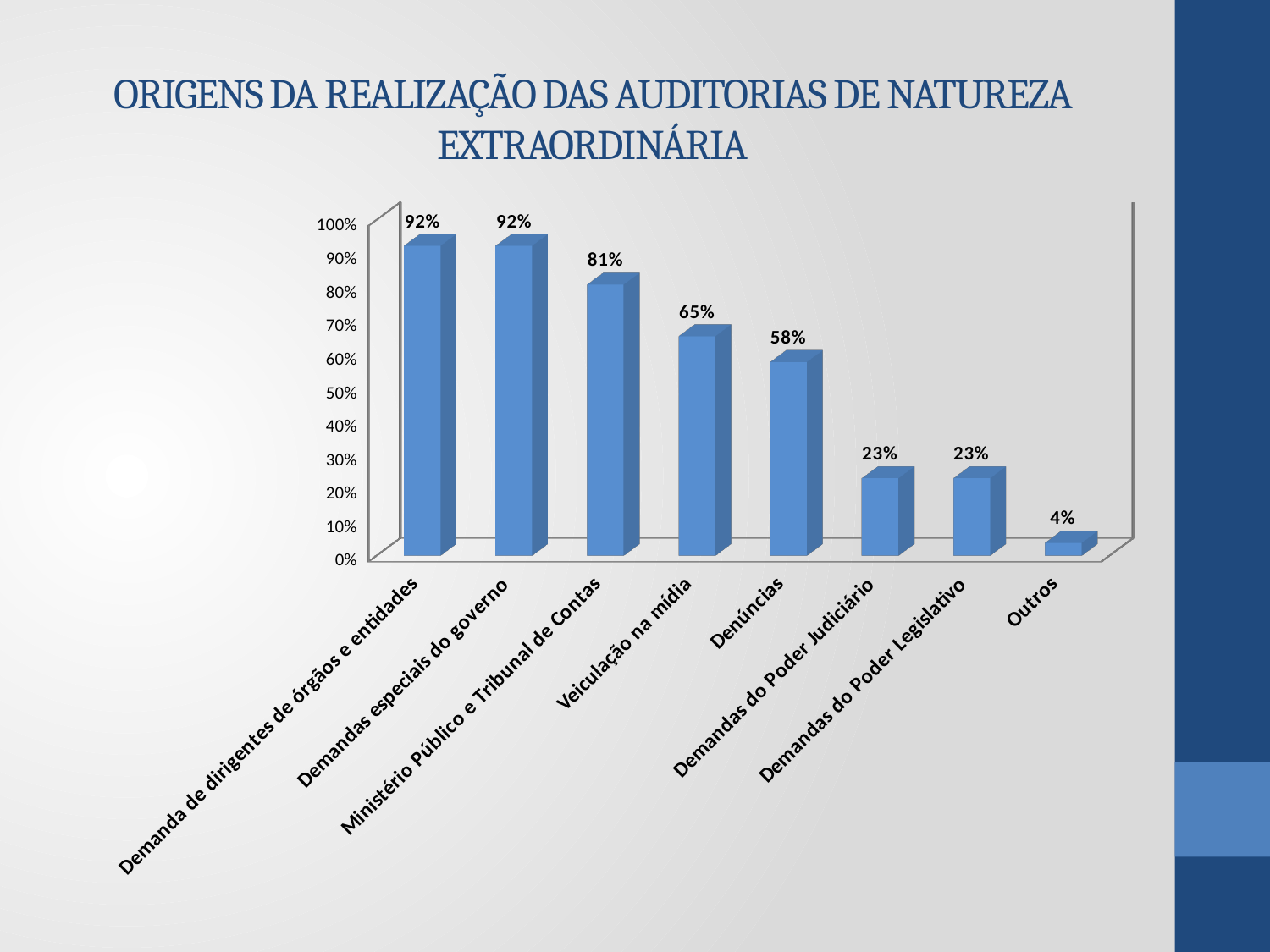
What is the difference between the values for Demandas especiais do governo and Outros? 88% How many categories are shown on the x axis? 8 Which is larger, the value for Veiculação na mídia or the value for Denúncias? Veiculação na mídia What is the value for Denúncias? 58% What is the difference between the values for Ministério Público e Tribunal de Contas and Denúncias? 23% What is the value for Ministério Público e Tribunal de Contas? 81% What kind of chart is shown on the slide? bar chart What is the value for Demandas do Poder Judiciário? 23% Which category has the lowest value? Outros What is the title of the slide? ORIGENS DA REALIZAÇÃO DAS AUDITORIAS DE NATUREZA EXTRAORDINÁRIA Do the values rise or fall from left to right along the x axis? fall What is the value for Veiculação na mídia? 65%